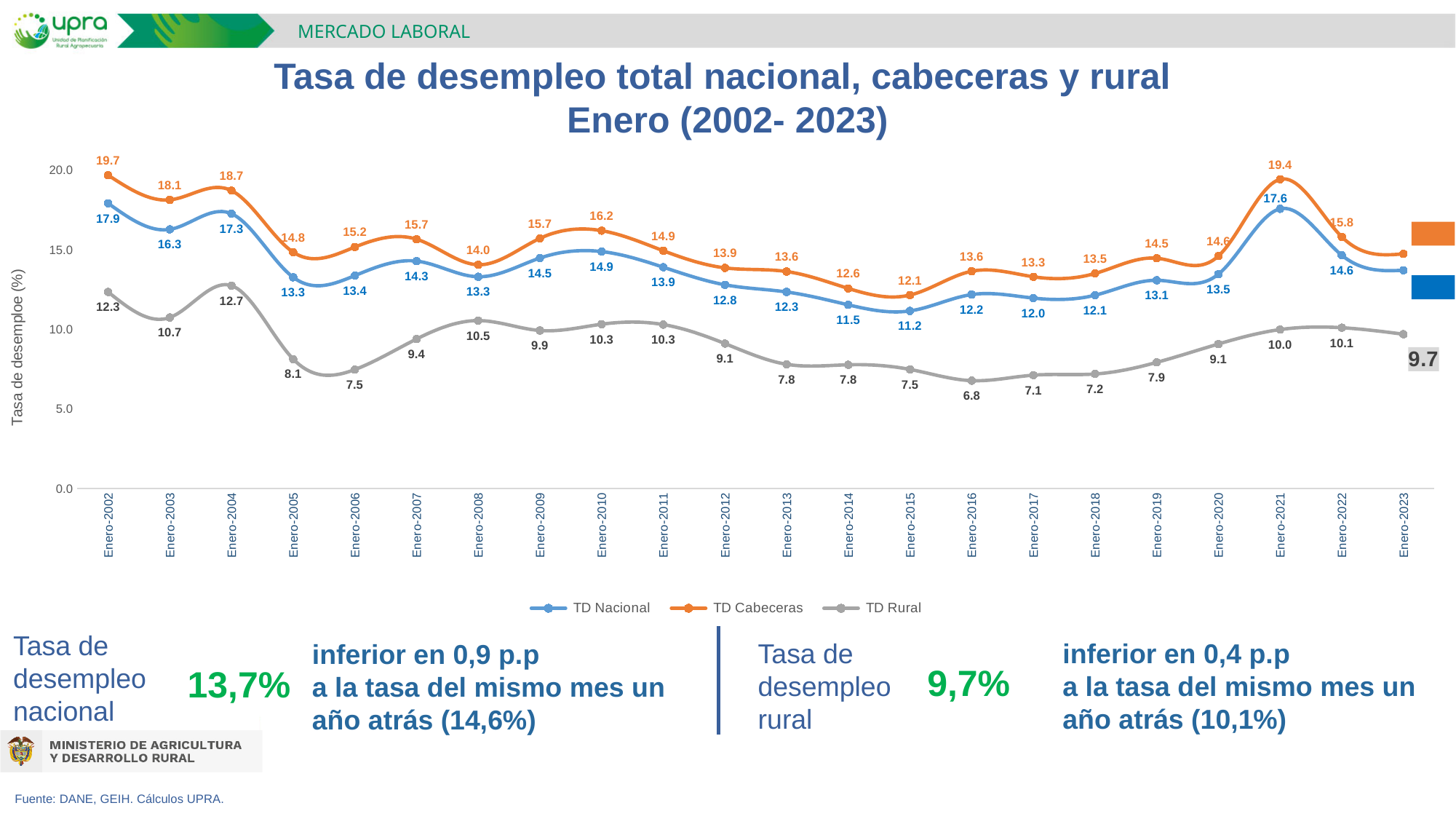
What is the value of TD Rural in Enero-2016? 6.8 In which year does TD Nacional reach its highest value? Enero-2002 Does TD Rural rise or fall from Enero-2015 to Enero-2021? Rise How many series does the legend list? 3 What is the value of TD Cabeceras in Enero-2002? 19.7 In which year does TD Rural reach its lowest value? Enero-2016 What is the difference between TD Cabeceras and TD Nacional in Enero-2021? 1.8 What kind of chart is shown on the slide? Line chart Which is larger for TD Rural: the value in Enero-2004 or in Enero-2002? Enero-2004 In which year does TD Cabeceras reach its lowest value? Enero-2015 What is the value of TD Nacional in Enero-2015? 11.2 How many time points (years) are plotted for each series? 22